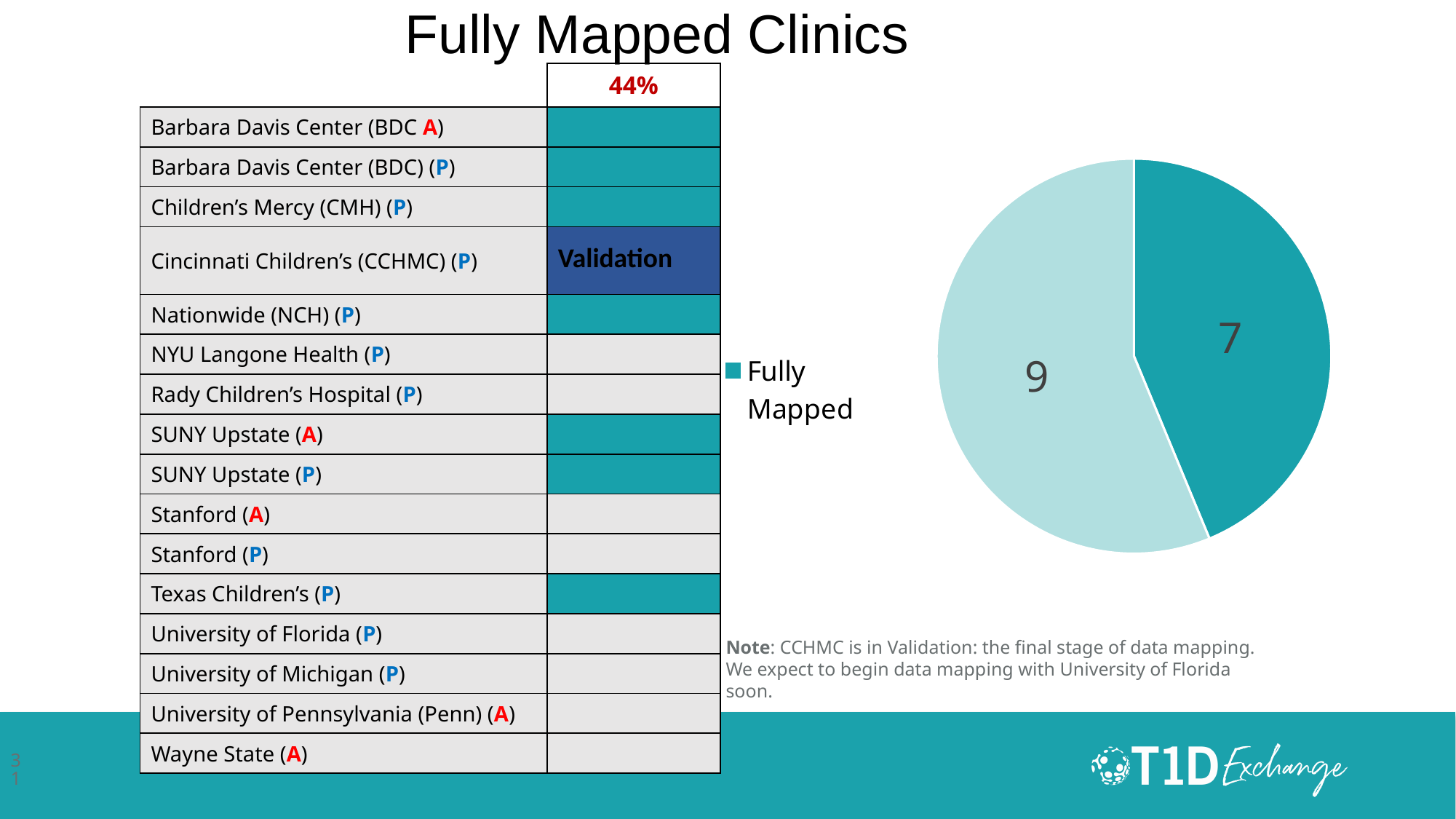
How many slices does the pie chart have? 2 How many entries does the pie chart's legend list? 1 In the pie chart, which slice is larger: the Fully Mapped slice or the other slice? the other slice (9) What share of the pie does the Fully Mapped slice (7 of 16) represent, as printed on the slide? 44% What is the total of the two slice values in the pie chart? 16 In the pie chart, what is the value of the smallest slice? 7 In the pie chart, what value is shown for the Fully Mapped slice? 7 What is the only entry in the pie chart's legend? Fully Mapped In the pie chart, what is the value of the largest slice? 9 In the pie chart, what is the difference between the two slice values? 2 What kind of chart is shown on the right of the slide? pie chart In the pie chart, what value is shown on the light-coloured slice that is not Fully Mapped? 9